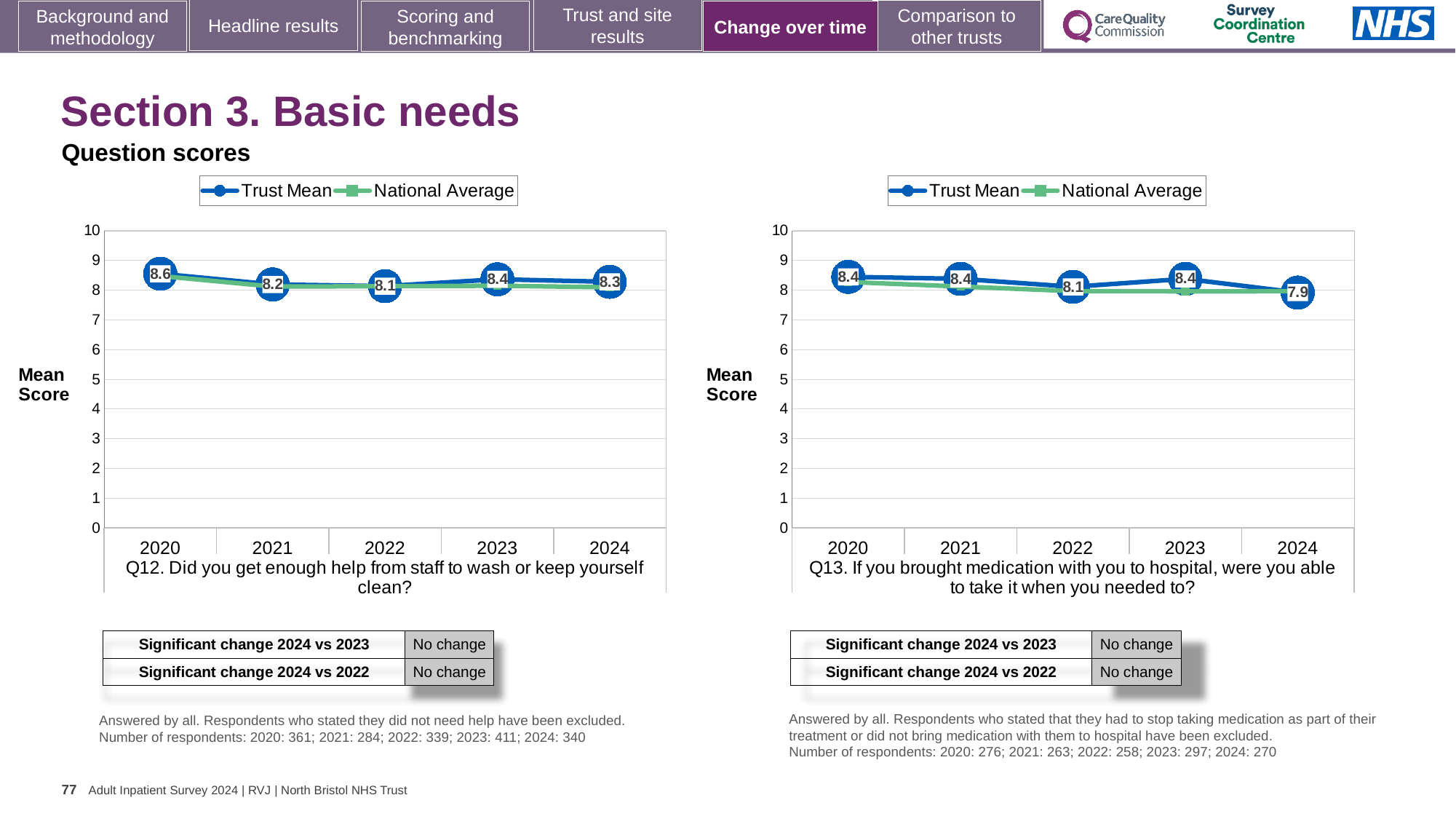
In the Q12 chart on the left, what is the Trust Mean score for 2020? 8.6 In the Q12 chart on the left, does the Trust Mean score rise or fall from 2020 to 2022? Fall In the Q13 chart on the right, which year has the lowest Trust Mean score? 2024 How many years are shown on the x axis of the Q13 chart on the right? 5 What type of chart is used for Q13 on the right? Line chart In the Q12 chart on the left, what is the difference between the Trust Mean scores for 2020 and 2022? 0.5 In the Q13 chart on the right, is the Trust Mean score higher in 2023 or in 2024? 2023 In the Q12 chart on the left, what is the Trust Mean score for 2023? 8.4 In the Q12 chart on the left, is the National Average value for 2020 greater or less than 8? greater In the Q13 chart on the right, what is the Trust Mean score for 2024? 7.9 How many series does the legend of the Q12 chart on the left list? 2 In the Q12 chart on the left, which year has the highest Trust Mean score? 2020